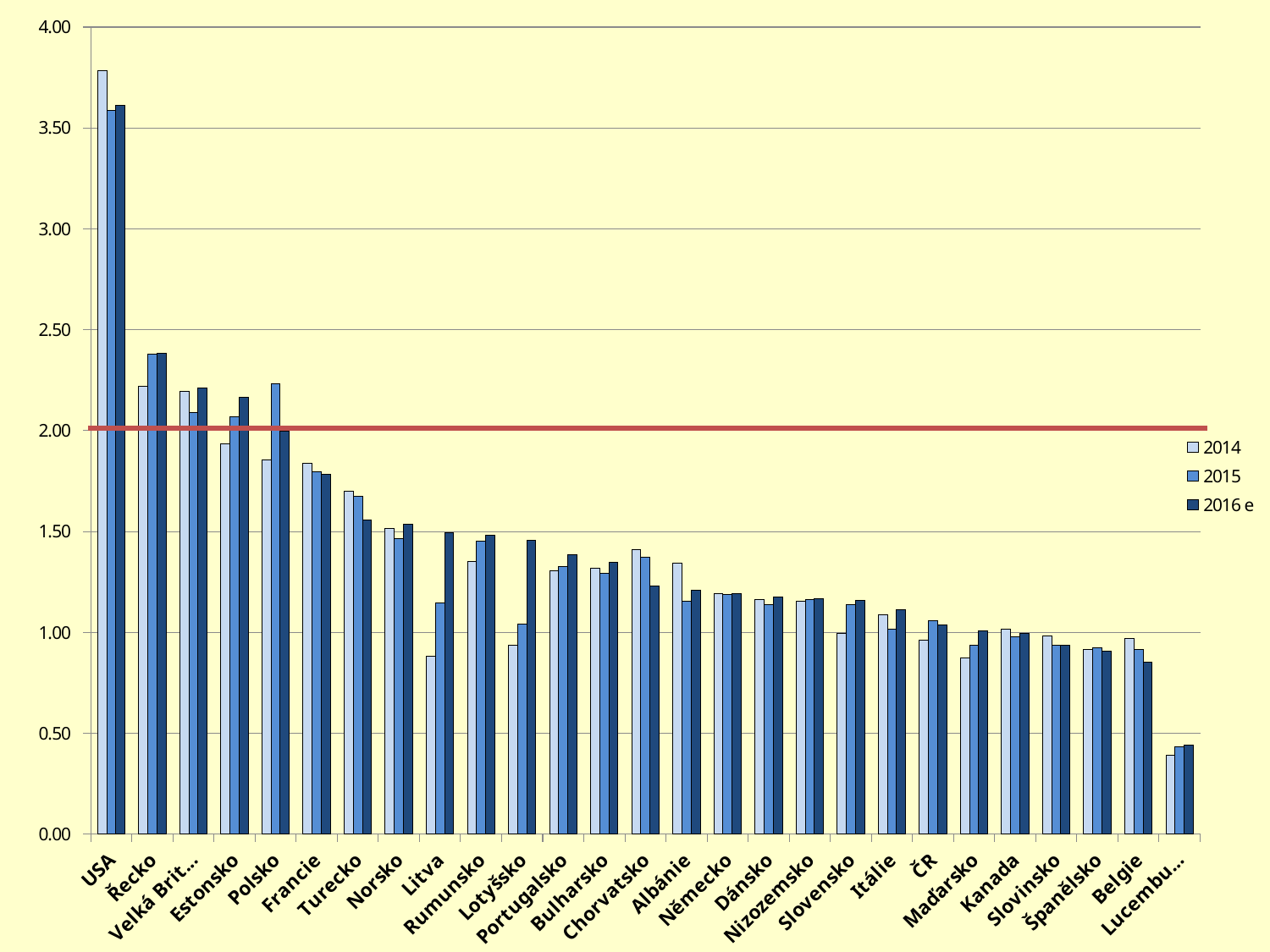
Is the 2016 e value for Belgie greater or less than 1.00? less Is the 2014 value for Francie greater or less than 2.00? less How many series does the legend list? 3 For Litva, which is larger: the 2014 value or the 2016 e value? 2016 e What kind of chart is shown on the slide? bar chart How many countries are shown on the x axis? 27 Is the 2014 value for USA greater or less than 3.50? greater At what value on the y axis is the red horizontal line drawn? 2.00 Which country has the highest value for 2014? USA For USA, which is larger: the 2014 value or the 2015 value? 2014